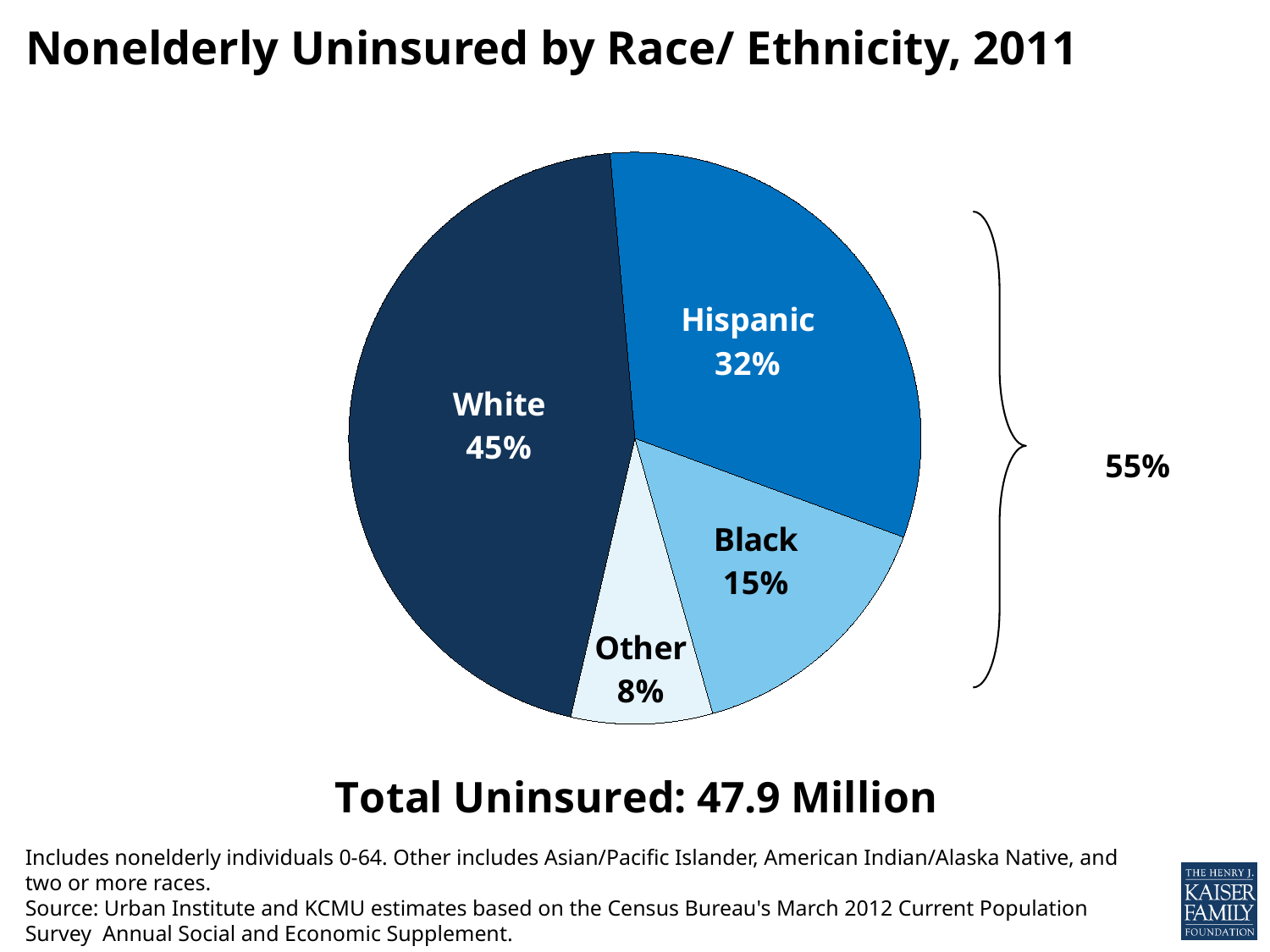
What kind of chart is shown on the slide? Pie chart Which is larger, the Black share or the Other share? Black What share of the nonelderly uninsured is Black? 15% Which race/ethnicity group has the smallest share of the nonelderly uninsured? Other What share of the nonelderly uninsured is White? 45% What share of the nonelderly uninsured is Other? 8% What is the total number of uninsured stated below the chart? 47.9 Million What combined share do the Hispanic, Black and Other groups make up, as shown by the bracket? 55% What share of the nonelderly uninsured is Hispanic? 32% How many race/ethnicity categories are shown in the pie chart? 4 What is the difference in percentage points between the White and Hispanic shares? 13 percentage points Which race/ethnicity group has the largest share of the nonelderly uninsured? White